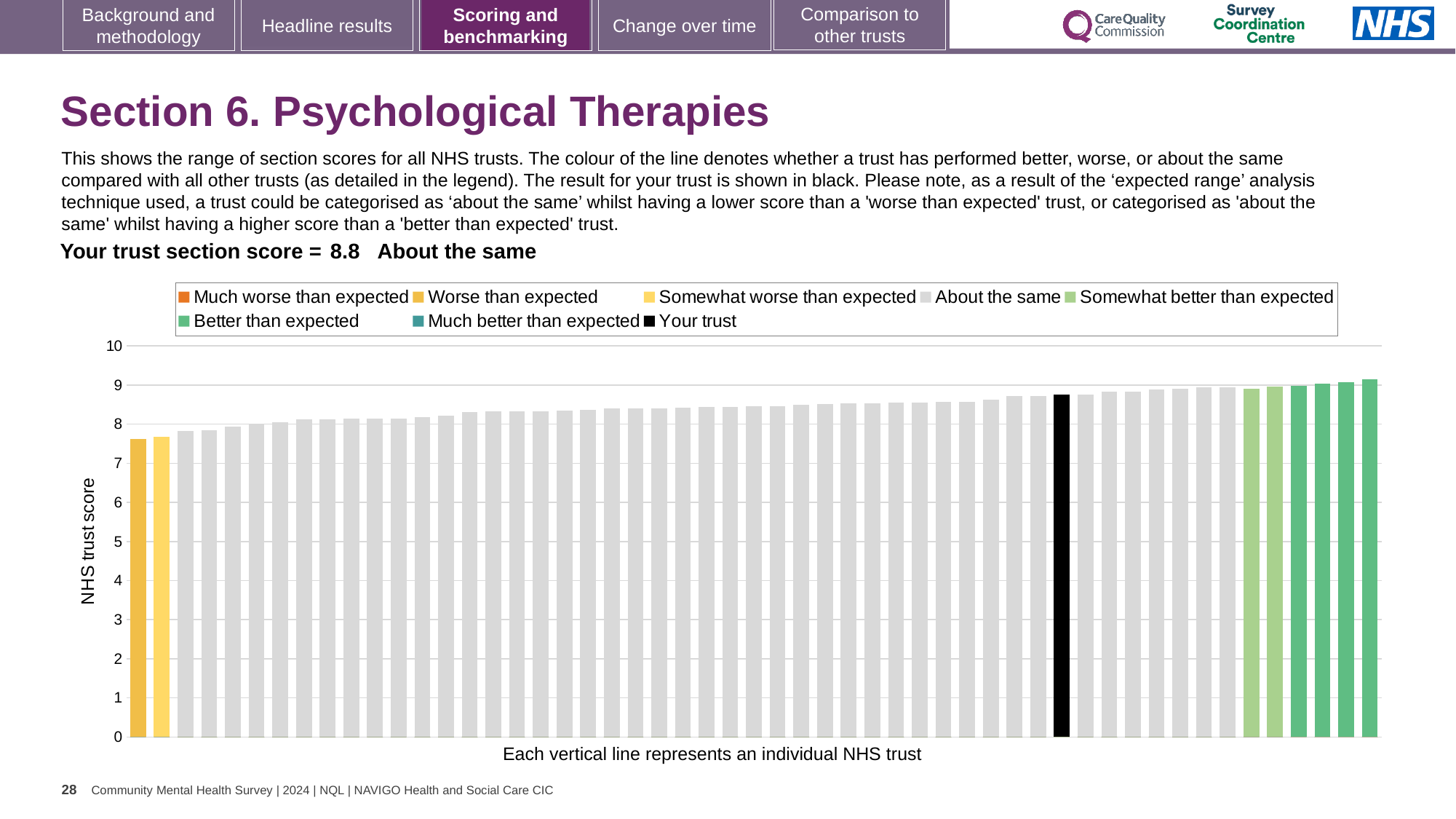
What is the label on the vertical axis of the chart? NHS trust score How many entries does the chart legend list? 8 What is the section score for your trust shown on the slide? 8.8 Do the bar values rise or fall from left to right along the x axis? rise Is the value for the rightmost (highest) trust bar greater or less than 8? greater Which is larger, the leftmost bar or the rightmost bar? the rightmost bar Is the value for the leftmost (lowest) trust bar greater or less than 8? less Is the value for your trust (the black bar) greater or less than 8? greater What kind of chart is shown on the slide? bar chart How many bars are coloured as 'Worse than expected' (yellow)? 1 What category is your trust placed in for this section? About the same